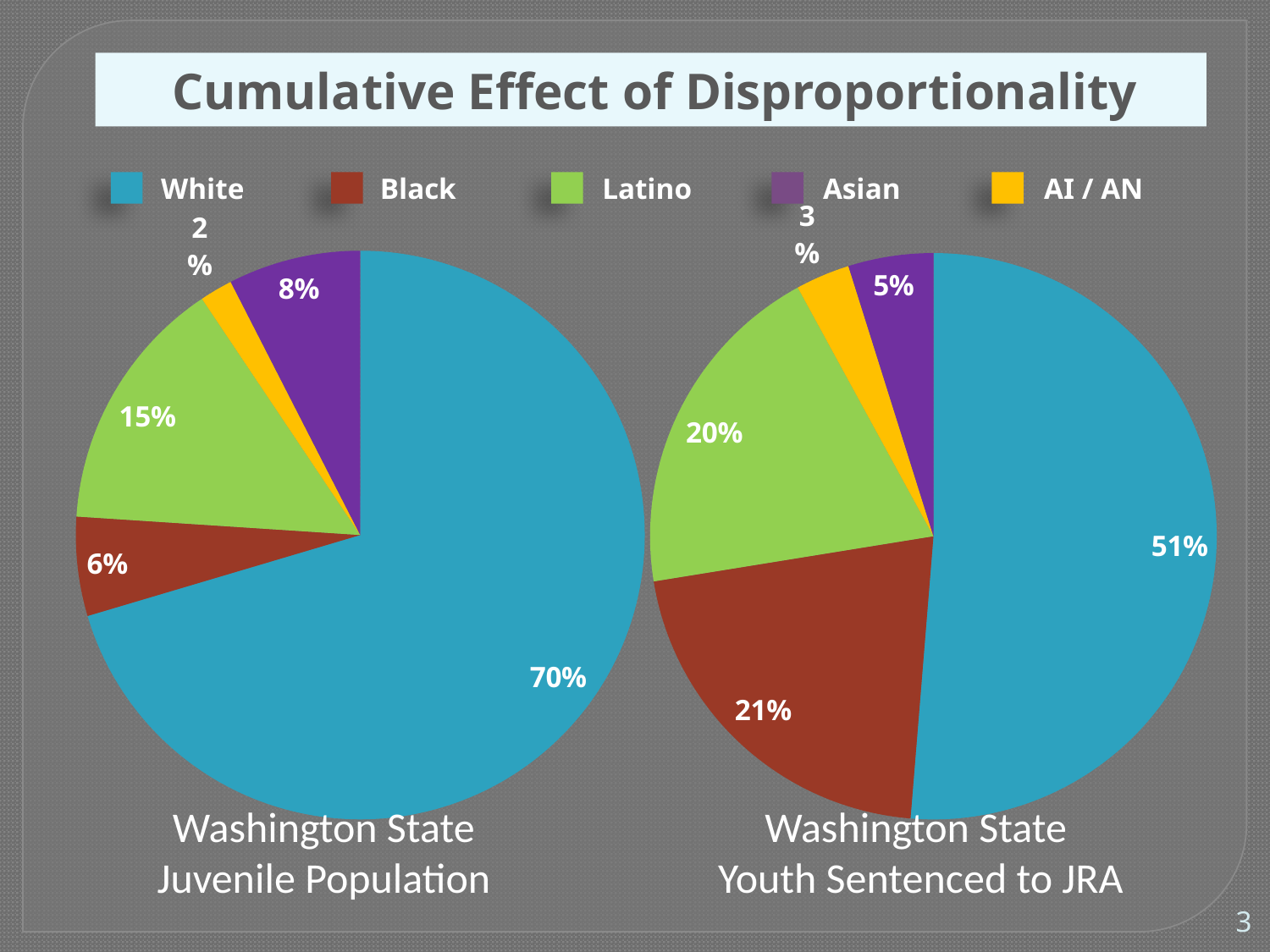
In the Washington State Youth Sentenced to JRA chart, what is the difference between the Black and Latino shares? 1% What is the title of the slide containing the two pie charts? Cumulative Effect of Disproportionality What is the difference between the White share in the Washington State Juvenile Population chart and the White share in the Washington State Youth Sentenced to JRA chart? 19% In the Washington State Youth Sentenced to JRA chart, what is the value for Asian? 5% In the Washington State Youth Sentenced to JRA chart, what share of the pie is Black? 21% What type of chart is used for Washington State Juvenile Population? Pie chart In the Washington State Juvenile Population chart, which category has the smallest slice? AI / AN In the Washington State Youth Sentenced to JRA chart, which category has the largest slice? White In the Washington State Juvenile Population chart, what share of the pie is White? 70% In the Washington State Juvenile Population chart, what is the value for Latino? 15% Is the Black share larger in the Washington State Juvenile Population chart or in the Washington State Youth Sentenced to JRA chart? Washington State Youth Sentenced to JRA How many categories does the legend list for the pie charts? 5